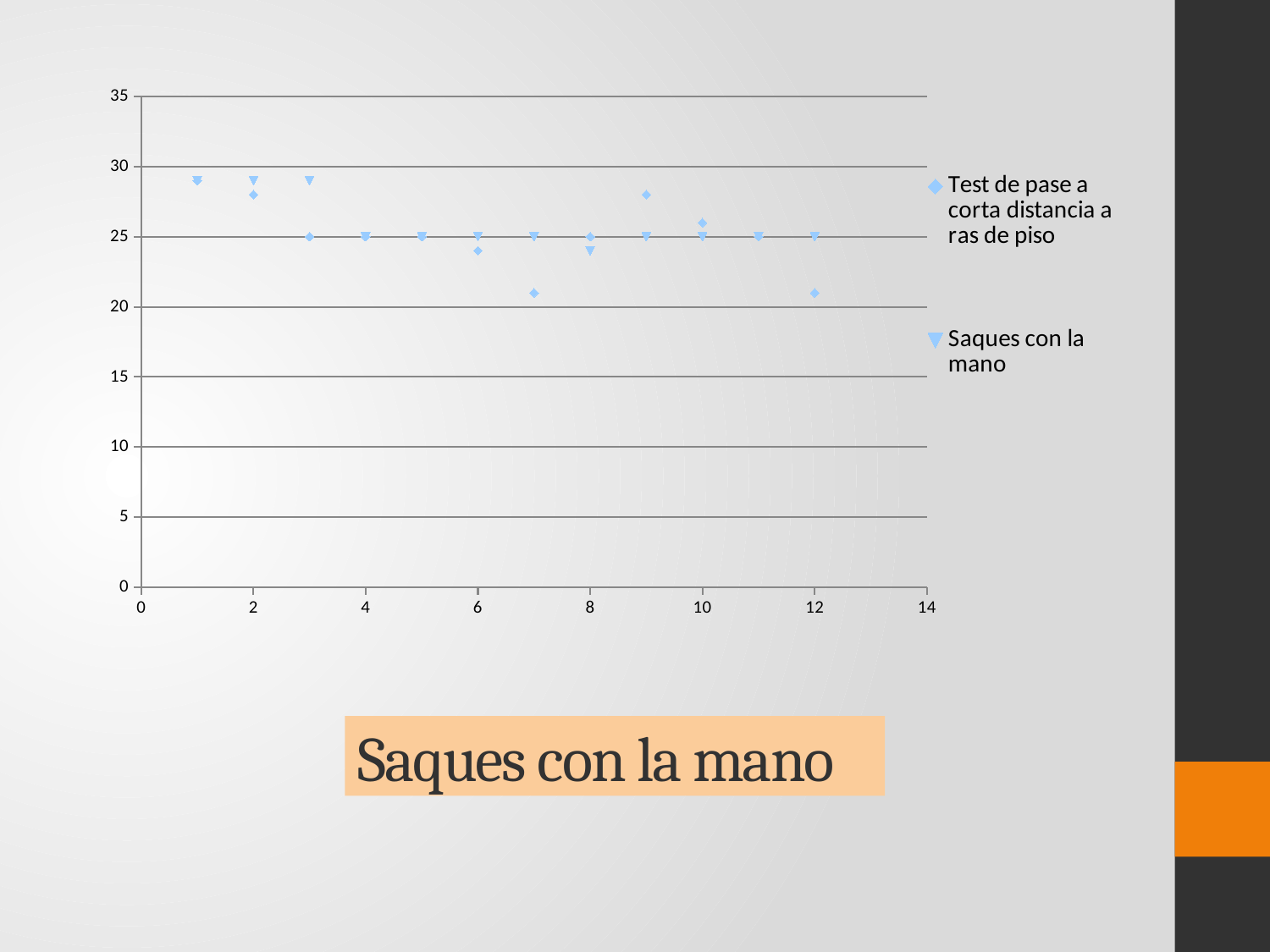
What is the value of 'Saques con la mano' at x = 10? 25 What kind of chart is shown on the slide? scatter chart How many data points does the 'Saques con la mano' series have? 12 What are the two series named in the legend? Test de pase a corta distancia a ras de piso; Saques con la mano At x = 3, which series has the larger value, 'Saques con la mano' or 'Test de pase a corta distancia a ras de piso'? Saques con la mano Is the value of 'Test de pase a corta distancia a ras de piso' at x = 7 greater or less than 25? less How many series does the legend list? 2 Is the value of 'Test de pase a corta distancia a ras de piso' at x = 12 greater or less than 25? less Is the value of 'Saques con la mano' at x = 1 greater or less than 25? greater At x = 9, which series has the larger value, 'Saques con la mano' or 'Test de pase a corta distancia a ras de piso'? Test de pase a corta distancia a ras de piso At x = 7, which series has the larger value, 'Saques con la mano' or 'Test de pase a corta distancia a ras de piso'? Saques con la mano